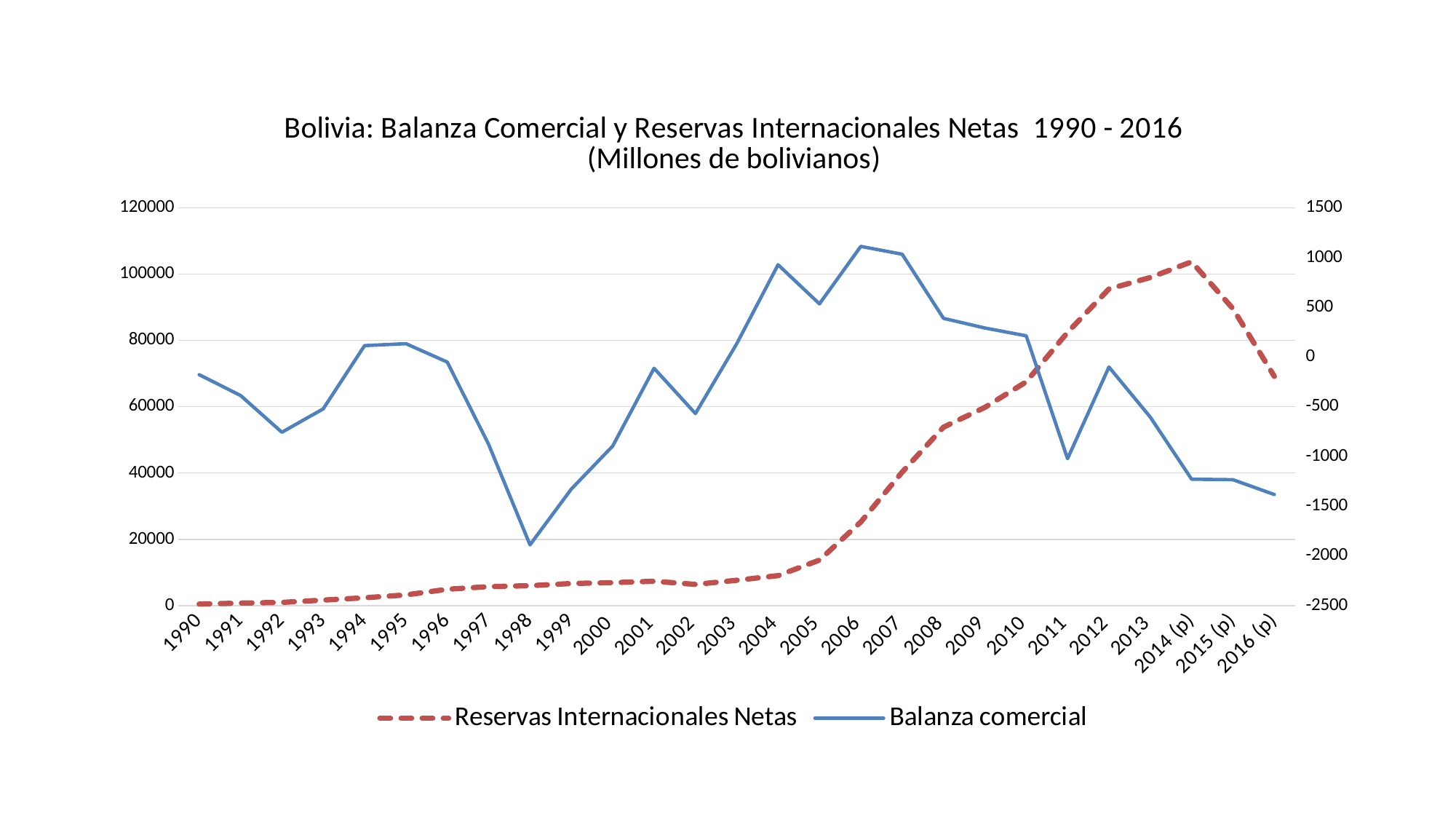
Which series is drawn with a dashed line in the legend? Reservas Internacionales Netas In which year does the Balanza comercial series reach its highest point? 2006 What kind of chart is shown on the slide? line chart In which year does the Reservas Internacionales Netas series reach its highest point? 2014 (p) Which year has the higher Reservas Internacionales Netas value, 2014 (p) or 2016 (p)? 2014 (p) Which year has the higher Balanza comercial value, 2004 or 2005? 2004 How many years are plotted along the x axis? 27 How many series does the legend list? 2 In which year does the Balanza comercial series reach its lowest point? 1998 Reading the left axis, is the value for Reservas Internacionales Netas in 2014 (p) greater or less than 80000? greater Does the Reservas Internacionales Netas series generally rise or fall from 1990 to 2014 (p)? rise Reading the left axis, is the value for Reservas Internacionales Netas in 2000 greater or less than 20000? less